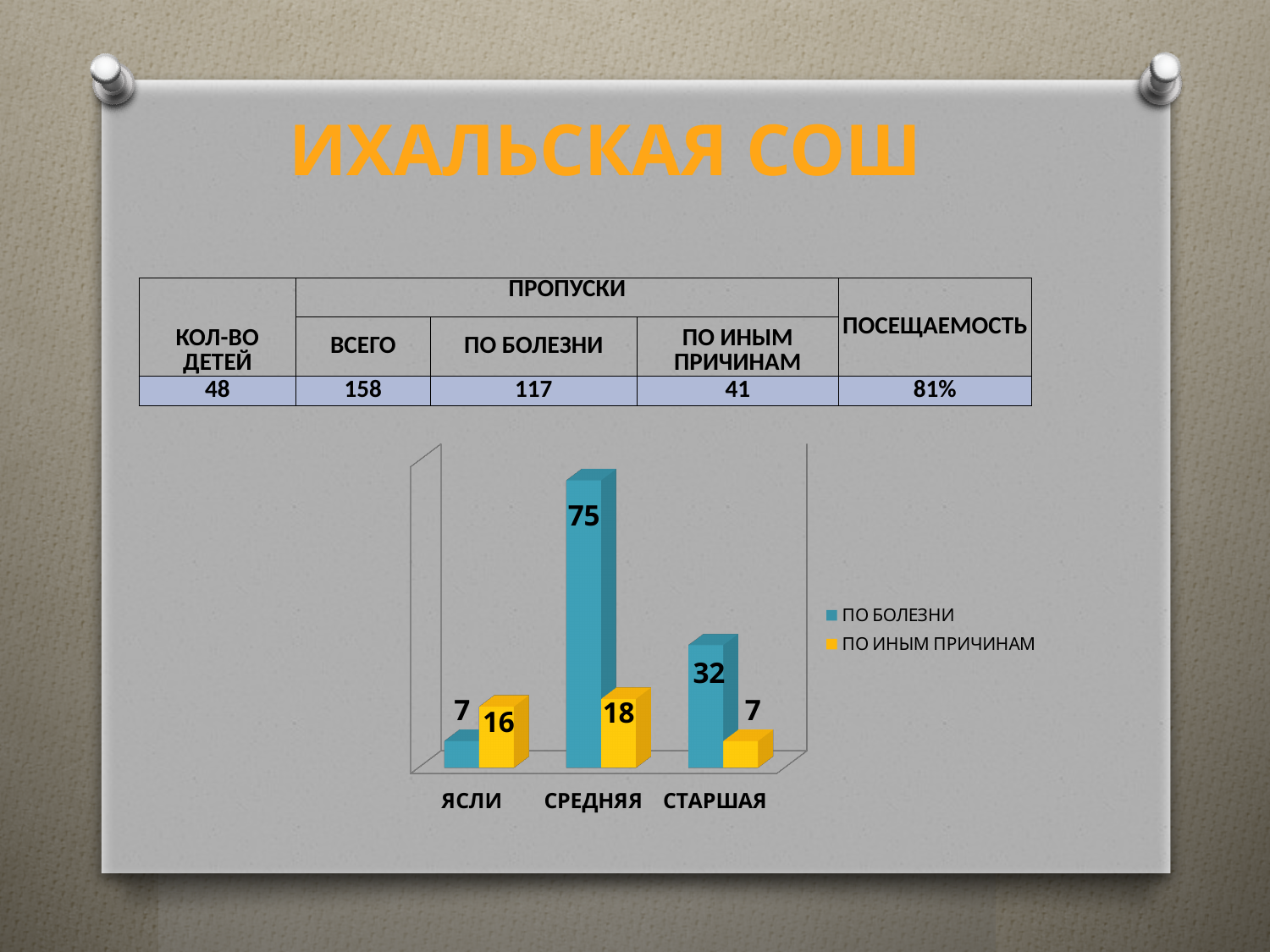
How many categories are shown on the x axis of the chart? 3 What is the value for ПО ИНЫМ ПРИЧИНАМ in the СТАРШАЯ category? 7 Which category has the lowest value for ПО ИНЫМ ПРИЧИНАМ? СТАРШАЯ Which category has the highest value for ПО БОЛЕЗНИ? СРЕДНЯЯ In the ЯСЛИ category, which series has the larger value: ПО БОЛЕЗНИ or ПО ИНЫМ ПРИЧИНАМ? ПО ИНЫМ ПРИЧИНАМ What is the value for ПО ИНЫМ ПРИЧИНАМ in the ЯСЛИ category? 16 How many series does the chart legend list? 2 What is the value for ПО БОЛЕЗНИ in the СРЕДНЯЯ category? 75 What is the difference between the ПО БОЛЕЗНИ and ПО ИНЫМ ПРИЧИНАМ values in the СРЕДНЯЯ category? 57 What kind of chart is shown on the slide? Bar chart Which colour represents the ПО ИНЫМ ПРИЧИНАМ series in the chart? Yellow What is the value for ПО БОЛЕЗНИ in the СТАРШАЯ category? 32